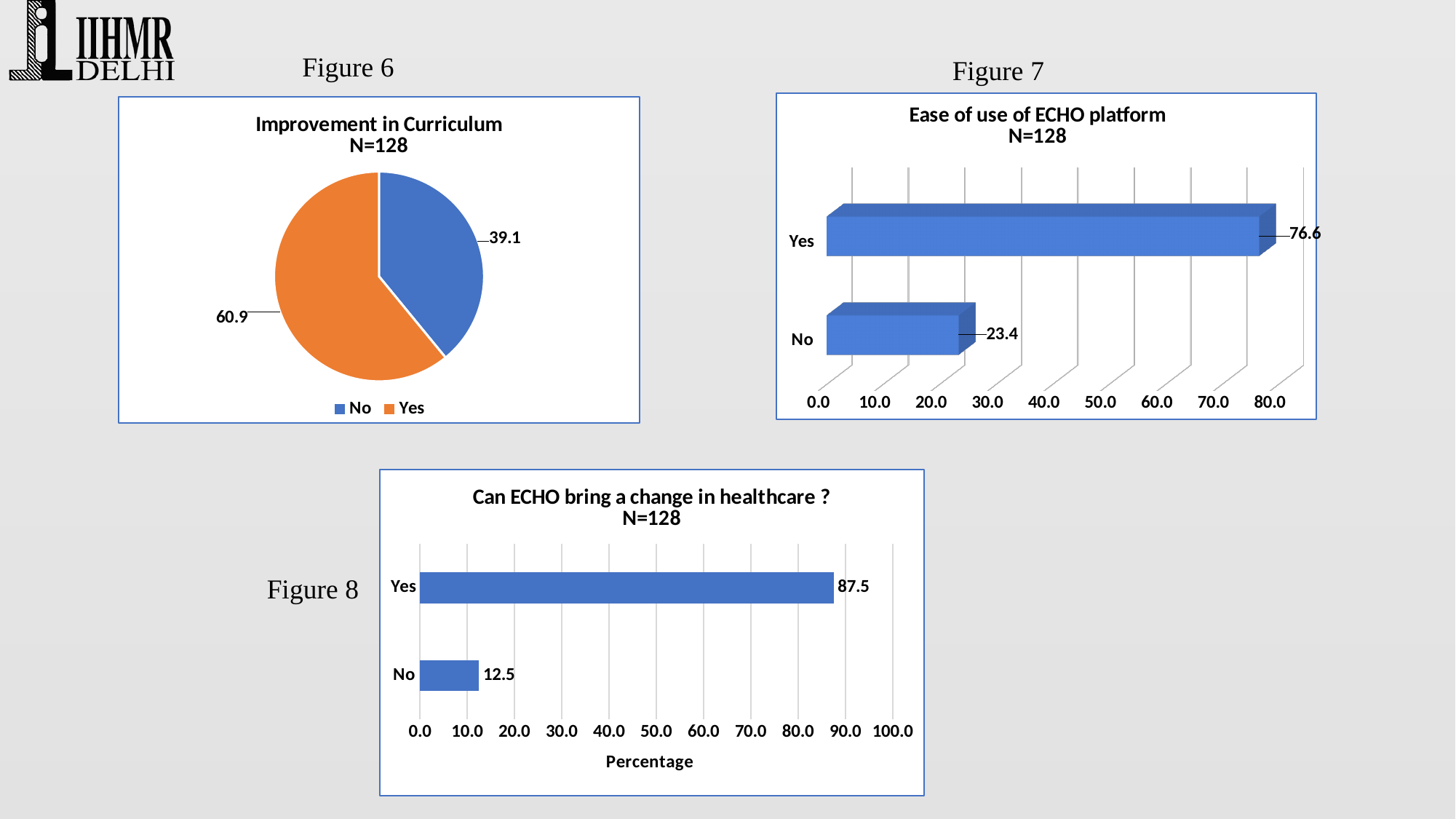
In the 'Can ECHO bring a change in healthcare ?' chart, what is the value for Yes? 87.5 What kind of chart is 'Ease of use of ECHO platform'? Bar chart In the 'Improvement in Curriculum' pie chart, what is the value for No? 39.1 In the 'Improvement in Curriculum' chart, which slice is larger, No or Yes? Yes In the 'Ease of use of ECHO platform' chart, what is the value for No? 23.4 In the 'Can ECHO bring a change in healthcare ?' chart, what is the value for No? 12.5 In the 'Can ECHO bring a change in healthcare ?' chart, which category has the lowest value? No In the 'Improvement in Curriculum' pie chart, what is the value for Yes? 60.9 In the 'Ease of use of ECHO platform' chart, what is the difference between the Yes and No values? 53.2 In the 'Ease of use of ECHO platform' chart, what is the value for Yes? 76.6 What kind of chart is 'Improvement in Curriculum'? Pie chart How many entries does the legend of the 'Improvement in Curriculum' chart list? 2